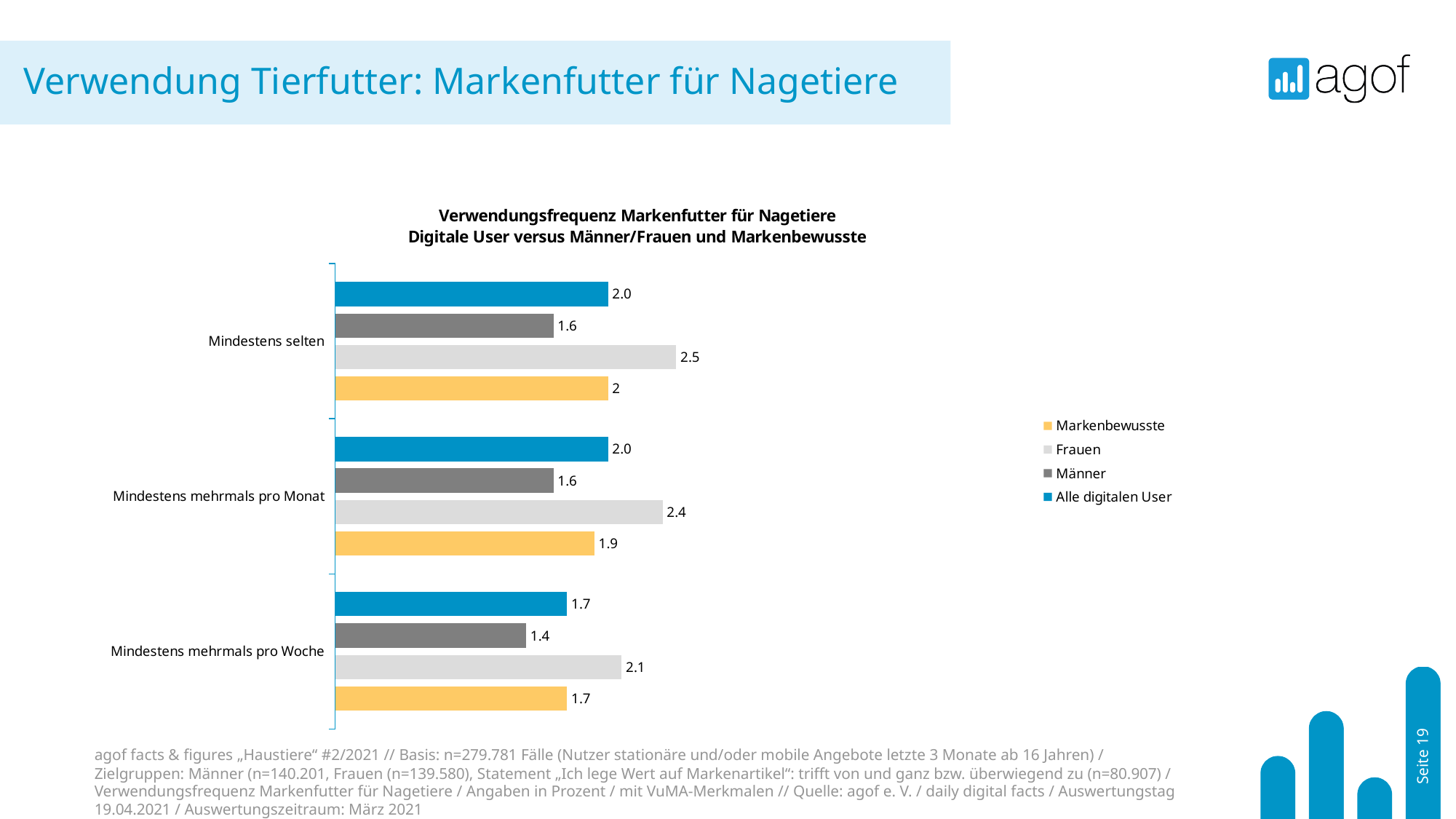
What is the value for Männer in the 'Mindestens mehrmals pro Woche' category? 1.4 Which series has the lowest value in the 'Mindestens mehrmals pro Monat' category? Männer How many categories are shown on the chart? 3 What is the value for Alle digitalen User in the 'Mindestens mehrmals pro Woche' category? 1.7 Which series has the highest value in the 'Mindestens selten' category? Frauen Which is larger in the 'Mindestens mehrmals pro Monat' category: the value for Frauen or the value for Alle digitalen User? Frauen What is the value for Frauen in the 'Mindestens selten' category? 2.5 What kind of chart is shown on the slide? Bar chart Which colour represents the Markenbewusste series in the chart? Yellow How many series does the legend list? 4 What is the difference between the Frauen and Männer values in the 'Mindestens mehrmals pro Woche' category? 0.7 What is the value for Markenbewusste in the 'Mindestens mehrmals pro Monat' category? 1.9